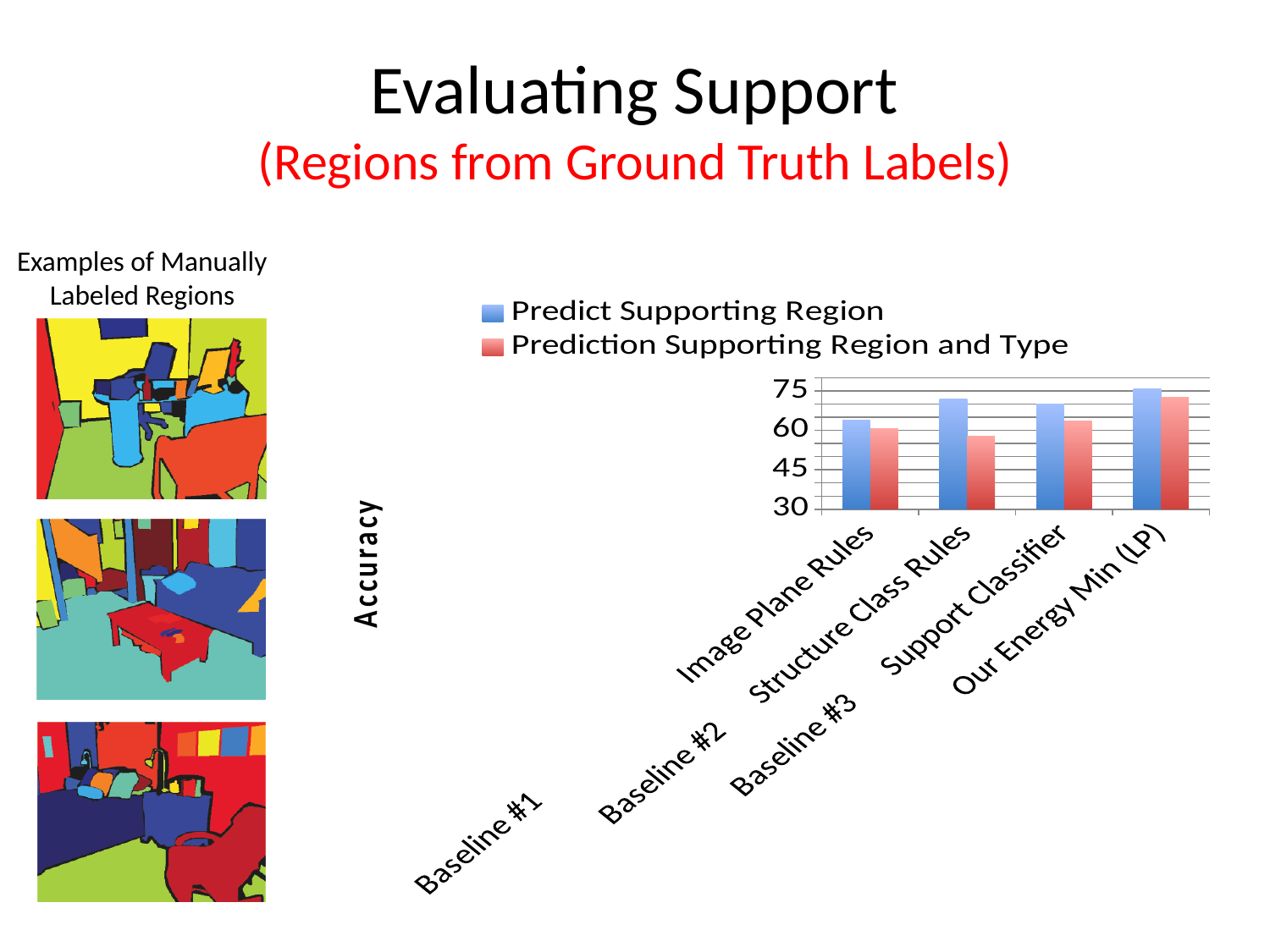
Which category has the highest value for the Predict Supporting Region series? Our Energy Min (LP) How many series does the chart's legend list? 2 Which colour represents the Prediction Supporting Region and Type series in the chart? red What is the label on the vertical axis of the chart? Accuracy What kind of chart is shown on the slide? bar chart Which category has the lowest value for the Predict Supporting Region series? Image Plane Rules Which category has the highest value for the Prediction Supporting Region and Type series? Our Energy Min (LP) Is the Predict Supporting Region value for Our Energy Min (LP) greater or less than 60? greater Is the Prediction Supporting Region and Type value for Structure Class Rules greater or less than 60? less For Structure Class Rules, which series has the larger value: Predict Supporting Region or Prediction Supporting Region and Type? Predict Supporting Region Is the Predict Supporting Region value for Structure Class Rules greater or less than 60? greater How many categories are shown along the x axis of the chart? 4